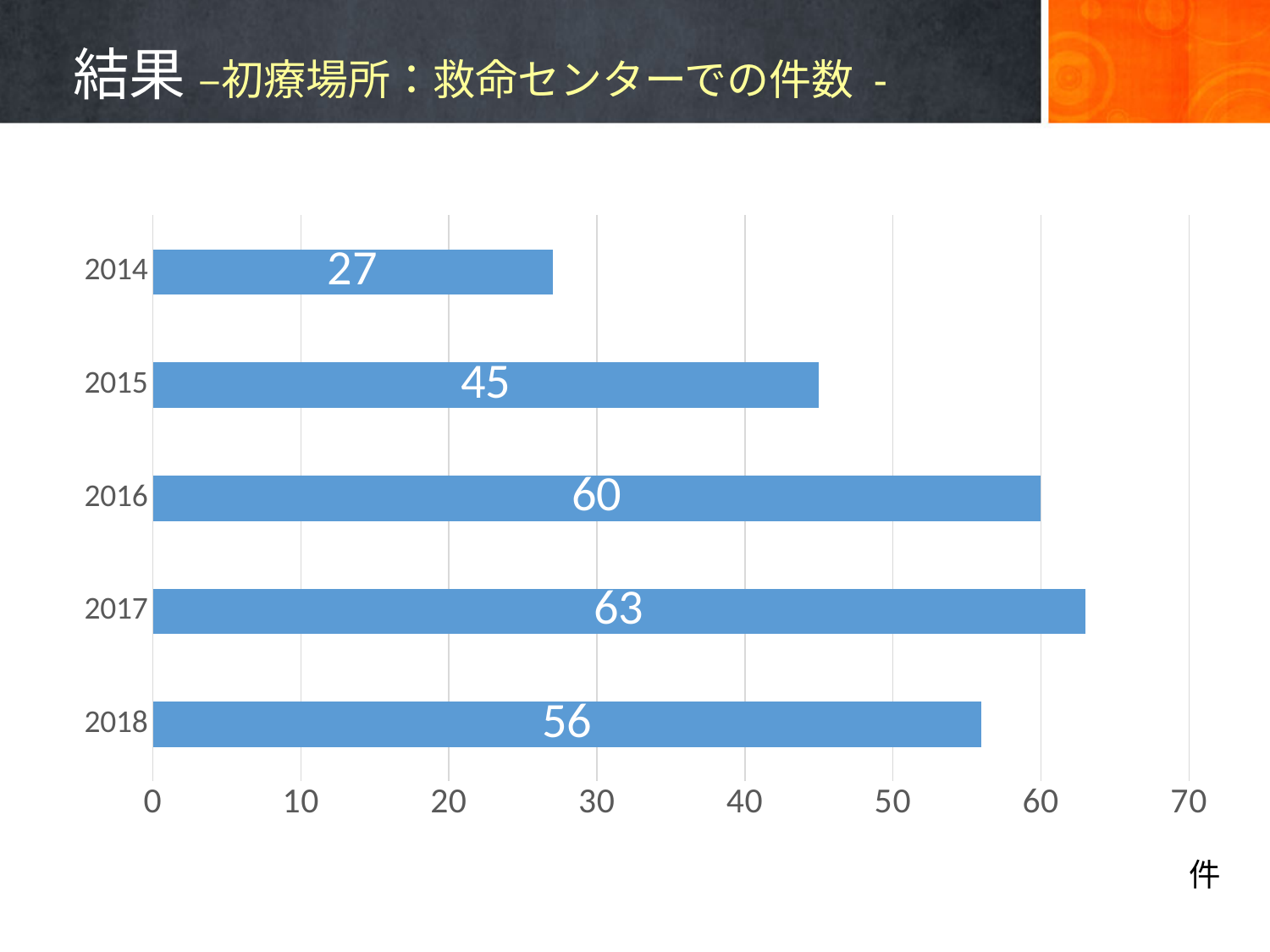
What is the value for 2017? 63 What kind of chart is shown on the slide? bar chart Which year has the highest value? 2017 Which year has the lowest value? 2014 Is the value for 2015 greater or less than 40? greater What is the difference between the values for 2016 and 2014? 33 How many years are shown on the chart? 5 What is the maximum value shown on the horizontal axis? 70 Which is larger, the value for 2015 or the value for 2018? 2018 What is the value for 2014? 27 What is the difference between the values for 2017 and 2018? 7 What is the value for 2018? 56